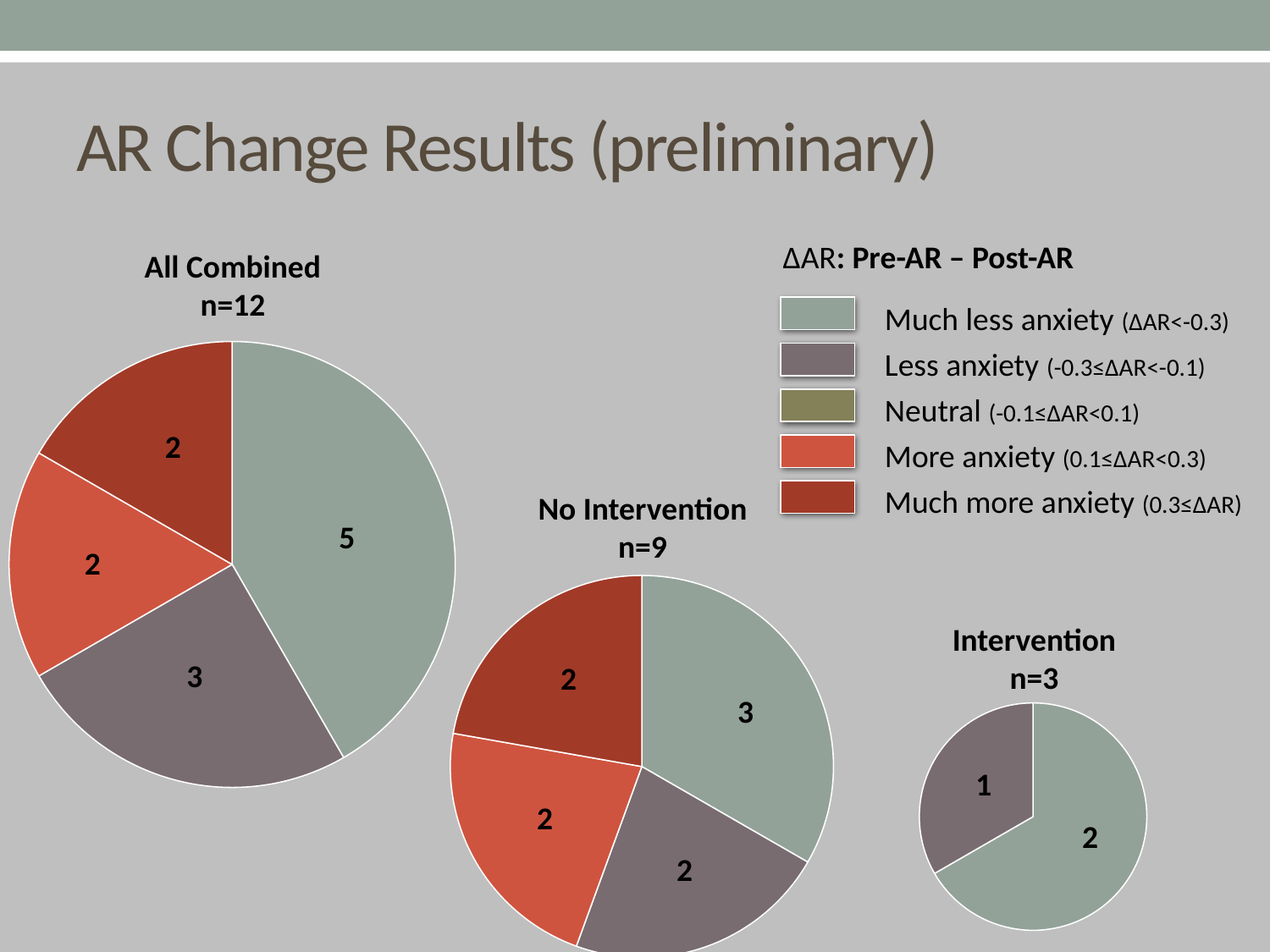
How many slices does the Intervention pie chart have? 2 In the Intervention pie chart, how many participants had less anxiety? 1 In the All Combined pie chart, how many participants had less anxiety? 3 In the No Intervention pie chart, how many participants had much less anxiety? 3 What type of charts are shown on the slide? Pie charts In the All Combined pie chart, what is the difference between the much less anxiety count and the less anxiety count? 2 How many categories does the legend list? 5 What is the sample size (n) shown for the No Intervention pie chart? n=9 In the All Combined pie chart, which category has the largest slice? Much less anxiety In the All Combined pie chart, how many participants had much less anxiety? 5 In the No Intervention pie chart, which is larger: the much less anxiety slice or the more anxiety slice? Much less anxiety In the Intervention pie chart, which category has the smallest slice? Less anxiety